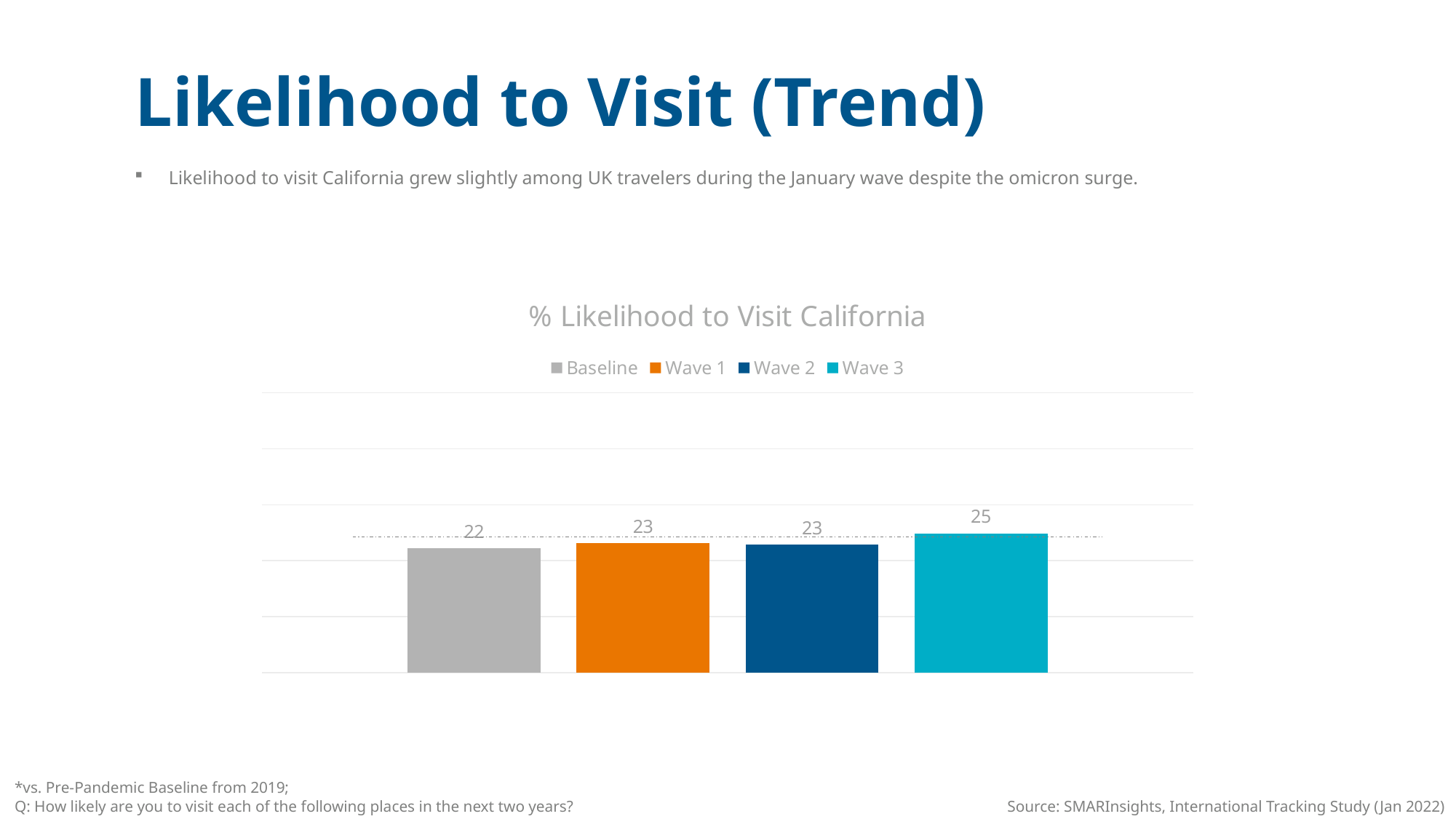
What is the difference between the Wave 3 and Baseline values in the % Likelihood to Visit California chart? 3 What colour is the Wave 1 bar in the % Likelihood to Visit California chart? Orange How many series does the legend list in the % Likelihood to Visit California chart? 4 Is the value for Wave 3 larger than the value for Wave 2 in the % Likelihood to Visit California chart? Yes What is the difference between the Wave 2 and Wave 1 values in the % Likelihood to Visit California chart? 0 What is the value for Wave 1 in the % Likelihood to Visit California chart? 23 What is the value for Baseline in the % Likelihood to Visit California chart? 22 Which series has the highest value in the % Likelihood to Visit California chart? Wave 3 What is the value for Wave 3 in the % Likelihood to Visit California chart? 25 Which series has the lowest value in the % Likelihood to Visit California chart? Baseline Do the values rise or fall from Baseline to Wave 3 in the % Likelihood to Visit California chart? Rise What kind of chart is the % Likelihood to Visit California chart? Bar chart